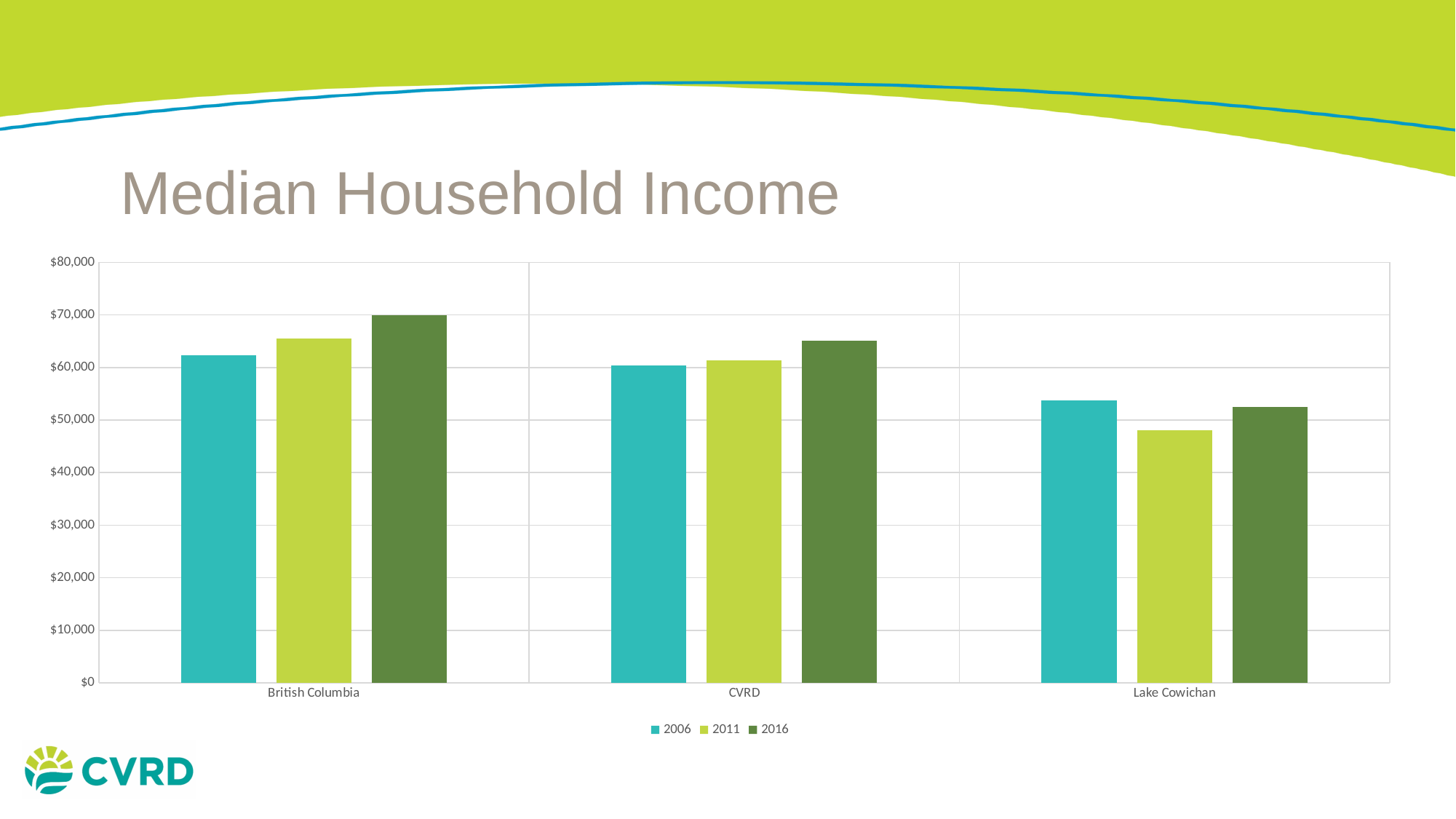
Which category has the highest 2016 value? British Columbia Is the 2016 value for British Columbia greater or less than $60,000? greater Do the values for British Columbia rise or fall from 2006 to 2016? rise Is the 2016 value for CVRD greater or less than $60,000? greater How many categories are shown on the x axis? 3 What is the title of the chart? Median Household Income Is the 2011 value for Lake Cowichan greater or less than $50,000? less What kind of chart is shown on the slide? bar chart Which category has the lowest 2011 value? Lake Cowichan How many series does the legend list? 3 Which is larger, the 2016 value for British Columbia or the 2016 value for CVRD? British Columbia Which legend entry is shown in the darkest green colour? 2016